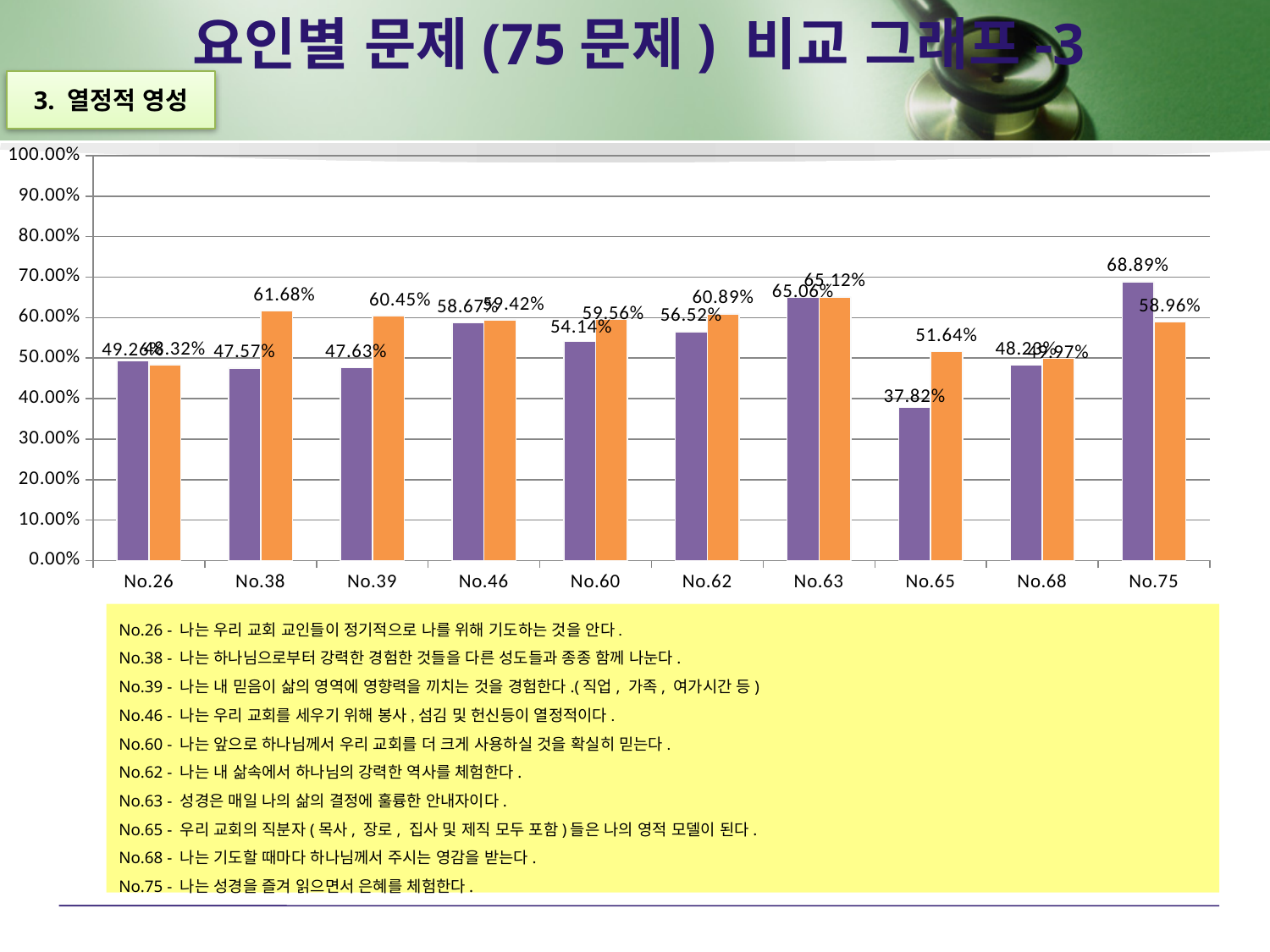
What is the difference between the orange bar and the purple bar for No.65? 13.82% How many categories are shown on the x axis? 10 What is the value of the purple bar for No.65? 37.82% Which category has the highest purple bar? No.75 What kind of chart is shown on the slide? bar chart What is the value of the orange bar for No.38? 61.68% Is the value of the purple bar for No.39 greater or less than 50.00%? less What is the value of the purple bar for No.75? 68.89% Which category has the highest orange bar? No.63 Which category has the lowest purple bar? No.65 What is the value of the orange bar for No.62? 60.89% For No.38, which bar is larger, the purple or the orange? orange